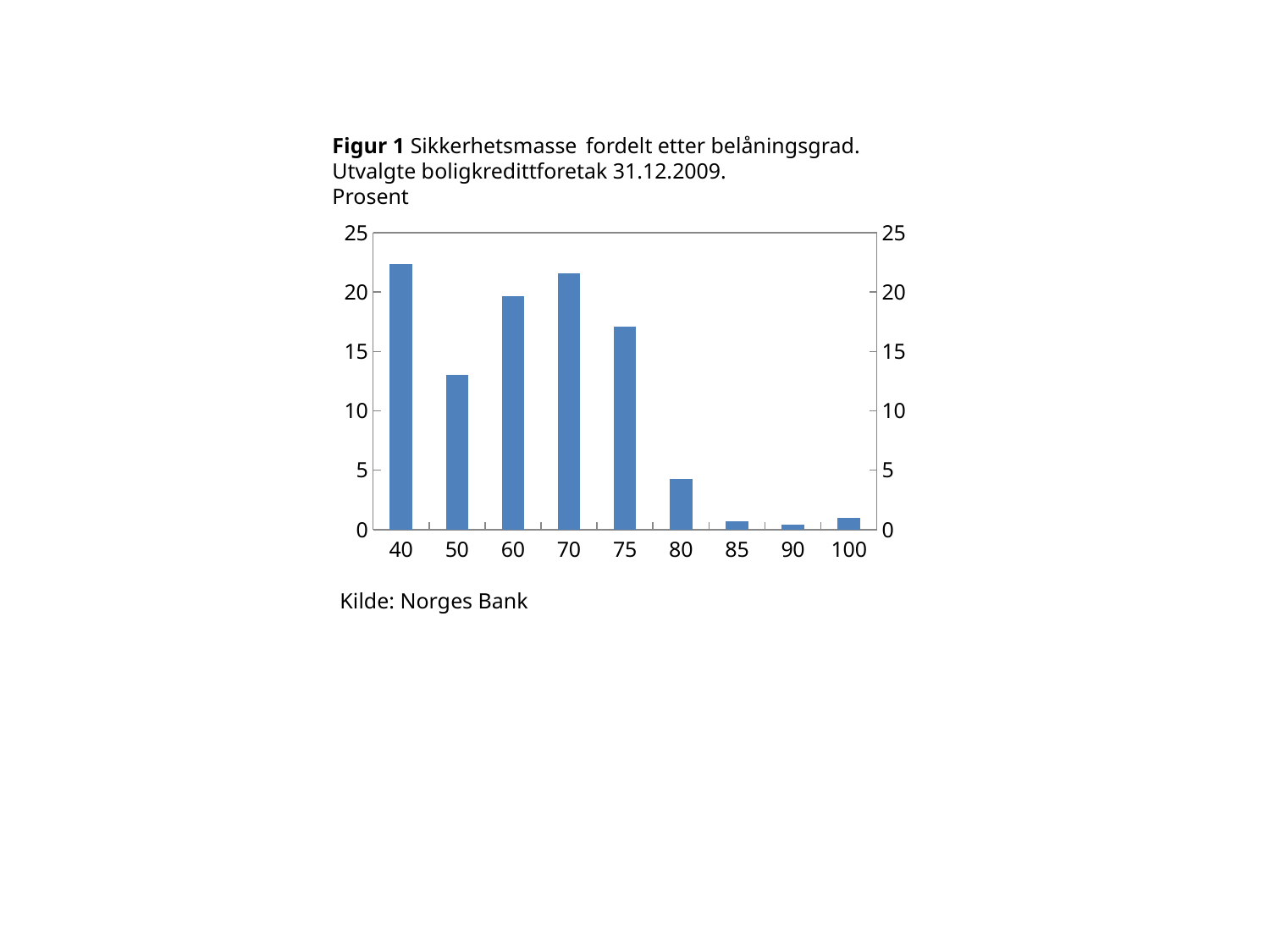
Is the value for category 80 greater or less than 5? less Which category has the highest bar in the chart? 40 What source is cited below the chart? Norges Bank How many categories are shown on the x axis of the chart? 9 Do the values rise or fall from category 75 to category 90? fall What kind of chart is shown on the slide? bar chart Is the value for category 60 greater or less than 15? greater Is the value for category 50 greater or less than 15? less Which is larger, the value for category 60 or the value for category 50? 60 Which is larger, the value for category 75 or the value for category 80? 75